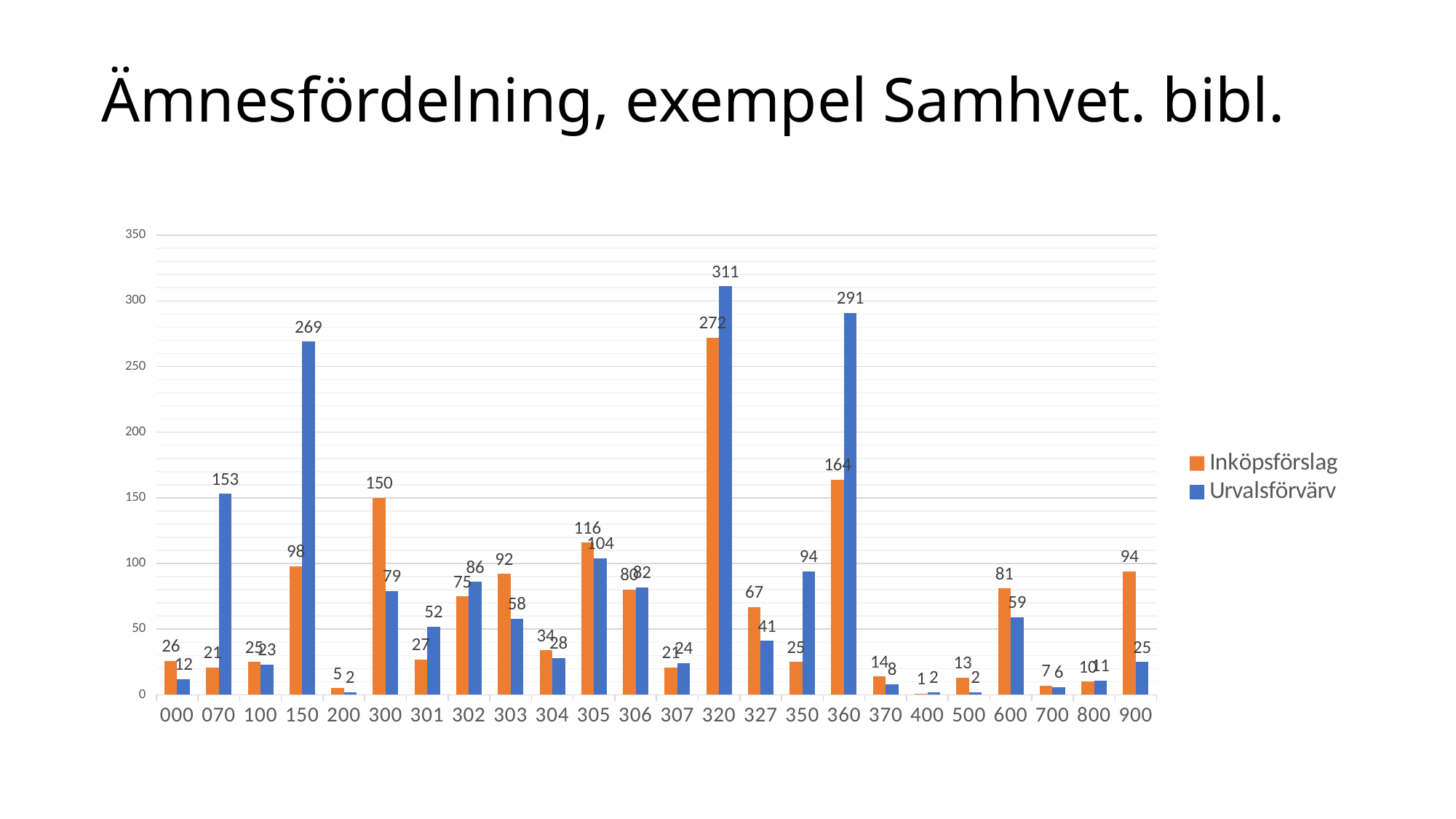
How many series does the legend list? 2 For category 070, how much larger is the Urvalsförvärv value than the Inköpsförslag value? 132 What is the Urvalsförvärv value for category 360? 291 For category 320, what is the difference between the Urvalsförvärv and Inköpsförslag values? 39 Which category has the highest Inköpsförslag value? 320 What are the two series named in the legend? Inköpsförslag and Urvalsförvärv What is the Urvalsförvärv value for category 150? 269 For category 900, which series has the larger value, Inköpsförslag or Urvalsförvärv? Inköpsförslag How many categories are shown on the x axis? 24 Which category has the highest Urvalsförvärv value? 320 What kind of chart is shown on the slide? Bar chart What is the Inköpsförslag value for category 300? 150